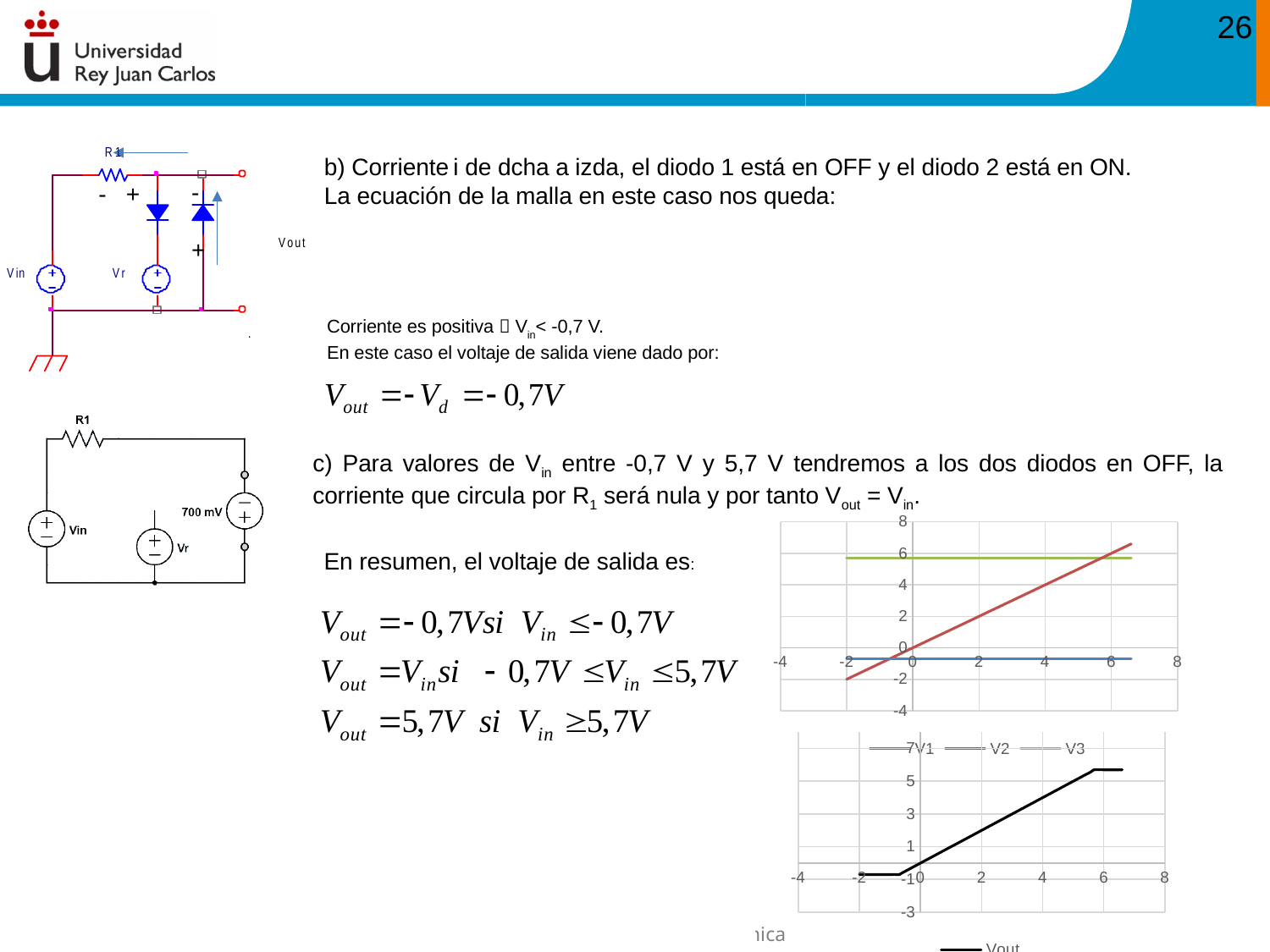
In the lower chart, is the value of Vout at x = 6 greater or less than 3? greater In the lower chart, does Vout overall rise or fall as x increases from -2 to 6? rise What is the name of the series plotted in the lower chart? Vout In the upper chart, is the value of the V3 series greater or less than 4? greater In the upper chart, which series has the larger value at x = 2: V2 or V3? V3 What kind of chart is the lower chart on the slide (the one with series Vout)? line chart What are the legend entries of the upper chart? V1, V2, V3 In the lower chart, is the value of Vout at x = -2 greater or less than 1? less What kind of chart is the upper chart on the slide (the one with series V1, V2 and V3)? line chart How many series does the legend of the upper chart list? 3